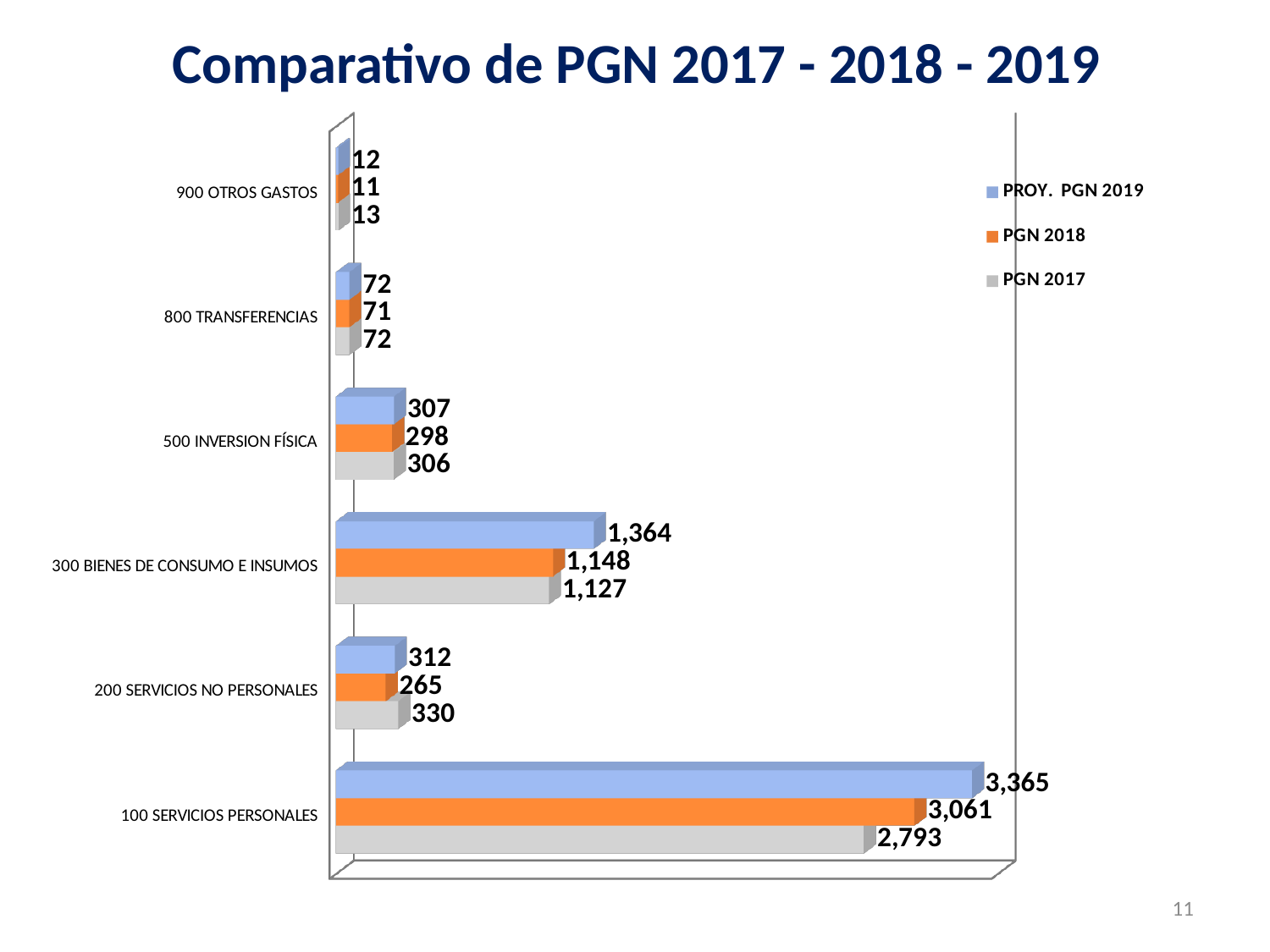
For 500 INVERSION FÍSICA, which is larger: the PROY. PGN 2019 value or the PGN 2018 value? PROY. PGN 2019 What is the PROY. PGN 2019 value for 100 SERVICIOS PERSONALES? 3,365 How many categories are shown on the chart? 6 Which category has the highest PGN 2018 value? 100 SERVICIOS PERSONALES What kind of chart is shown on the slide? Bar chart Which category has the lowest PROY. PGN 2019 value? 900 OTROS GASTOS What is the title of the chart? Comparativo de PGN 2017 - 2018 - 2019 How many series does the legend list? 3 What is the difference between the PROY. PGN 2019 and PGN 2018 values for 100 SERVICIOS PERSONALES? 304 What is the PGN 2017 value for 300 BIENES DE CONSUMO E INSUMOS? 1,127 What is the PGN 2018 value for 200 SERVICIOS NO PERSONALES? 265 What is the difference between the PGN 2017 and PGN 2018 values for 200 SERVICIOS NO PERSONALES? 65